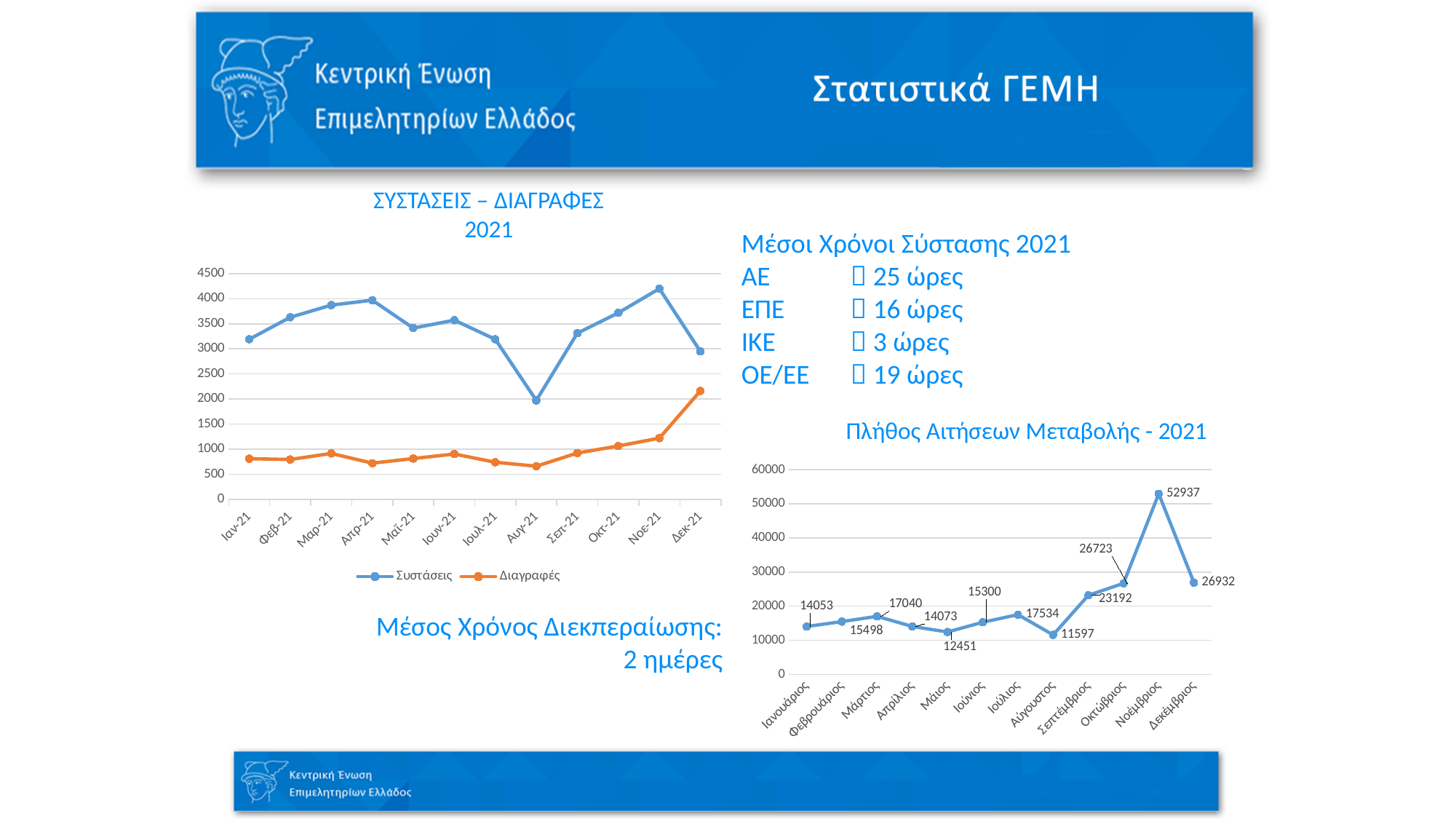
On the chart titled 'ΣΥΣΤΑΣΕΙΣ – ΔΙΑΓΡΑΦΕΣ 2021', is the value of Συστάσεις for Νοε-21 greater or less than 4000? greater On the chart titled 'ΣΥΣΤΑΣΕΙΣ – ΔΙΑΓΡΑΦΕΣ 2021', how many series does the legend list? 2 On the chart titled 'ΣΥΣΤΑΣΕΙΣ – ΔΙΑΓΡΑΦΕΣ 2021', is the value of Διαγραφές for Ιαν-21 greater or less than 1000? less On the chart titled 'Πλήθος Αιτήσεων Μεταβολής - 2021', which is larger, the value for Μάρτιος or the value for Ιούλιος? Ιούλιος What kind of chart is the chart titled 'ΣΥΣΤΑΣΕΙΣ – ΔΙΑΓΡΑΦΕΣ 2021'? Line chart On the chart titled 'ΣΥΣΤΑΣΕΙΣ – ΔΙΑΓΡΑΦΕΣ 2021', in which month does the Συστάσεις series reach its lowest value? Αυγ-21 On the chart titled 'Πλήθος Αιτήσεων Μεταβολής - 2021', what is the value for Αύγουστος? 11597 On the chart titled 'Πλήθος Αιτήσεων Μεταβολής - 2021', what is the value for Νοέμβριος? 52937 On the chart titled 'Πλήθος Αιτήσεων Μεταβολής - 2021', which month has the highest value? Νοέμβριος On the chart titled 'Πλήθος Αιτήσεων Μεταβολής - 2021', how many months are plotted? 12 On the chart titled 'Πλήθος Αιτήσεων Μεταβολής - 2021', which month has the lowest value? Αύγουστος On the chart titled 'Πλήθος Αιτήσεων Μεταβολής - 2021', what is the difference between the values for Νοέμβριος and Δεκέμβριος? 26005